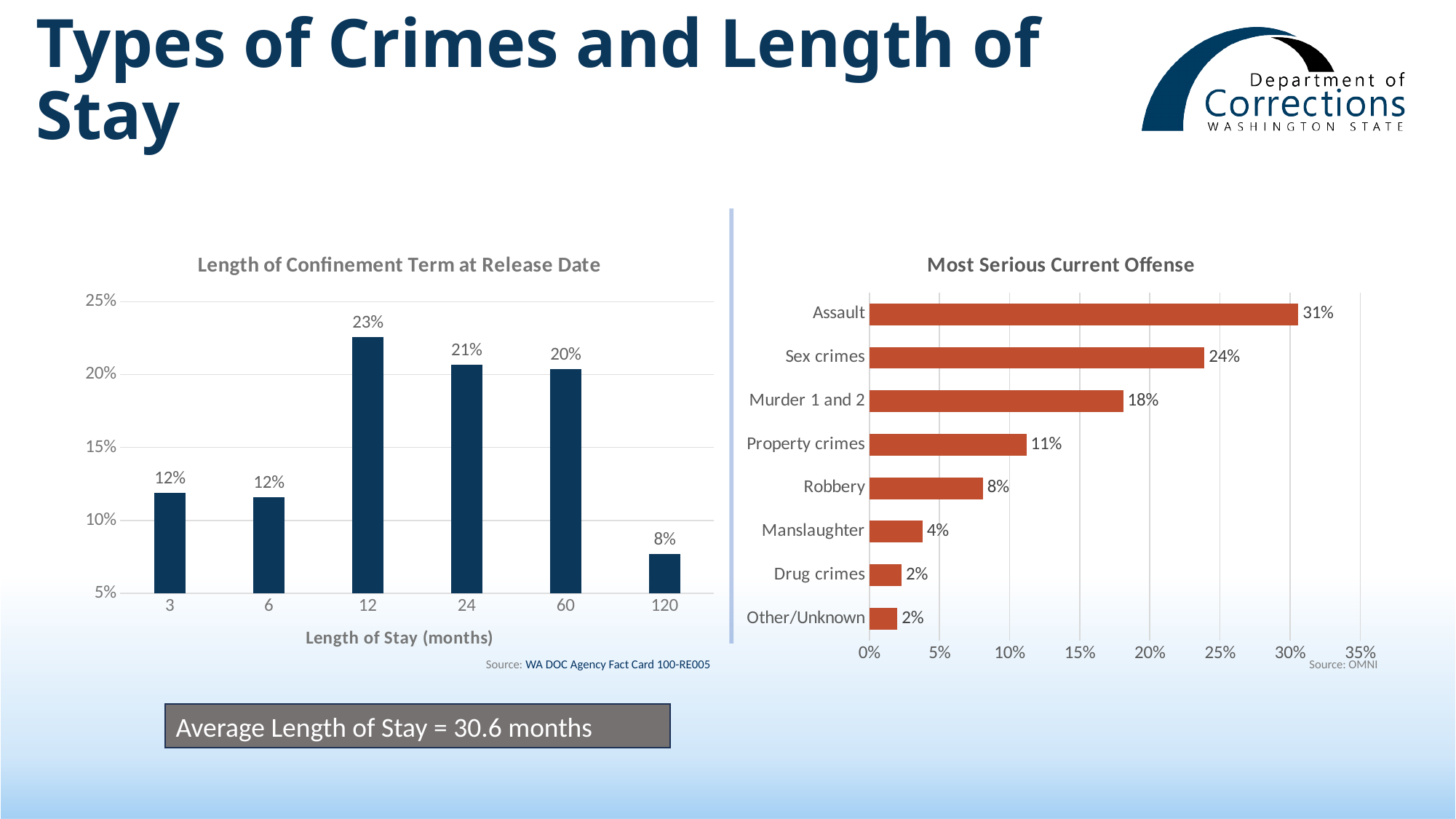
In the 'Length of Confinement Term at Release Date' chart, how many length-of-stay categories are shown? 6 What is the x-axis title of the 'Length of Confinement Term at Release Date' chart? Length of Stay (months) In the 'Most Serious Current Offense' chart, how many offense categories are shown? 8 In the 'Most Serious Current Offense' chart, what is the value for Murder 1 and 2? 18% In the 'Most Serious Current Offense' chart, which offense has the highest value? Assault In the 'Most Serious Current Offense' chart, what is the difference between the values for Assault and Sex crimes? 7% In the 'Length of Confinement Term at Release Date' chart, which length of stay has the highest value? 12 In the 'Length of Confinement Term at Release Date' chart, what is the value for a length of stay of 12 months? 23% What kind of chart is 'Length of Confinement Term at Release Date'? Bar chart In the 'Length of Confinement Term at Release Date' chart, which length of stay has the lowest value? 120 In the 'Most Serious Current Offense' chart, which is larger, the value for Robbery or the value for Manslaughter? Robbery In the 'Length of Confinement Term at Release Date' chart, what is the difference between the values for 24 months and 120 months? 13%